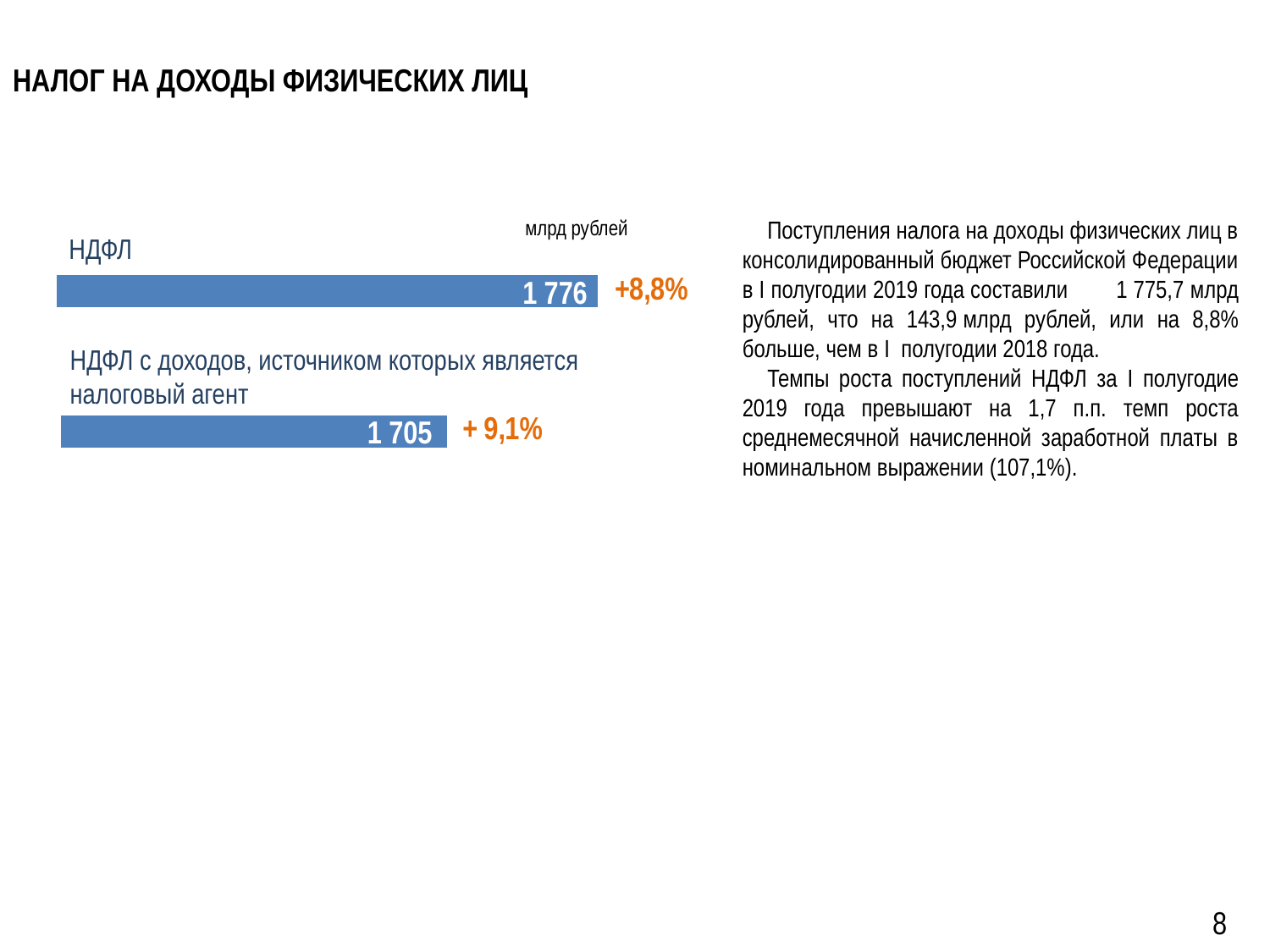
How many bars are shown in the chart? 2 What is the difference between the НДФЛ bar value and the bar for НДФЛ с доходов, источником которых является налоговый агент? 71 What growth rate is shown next to the bar for НДФЛ с доходов, источником которых является налоговый агент? + 9,1% What colour are the bars in the chart? Blue What growth rate is shown next to the НДФЛ bar? +8,8% What is the value shown on the bar for НДФЛ с доходов, источником которых является налоговый агент? 1 705 What kind of chart is shown on the slide? Bar chart What is the value shown on the bar for НДФЛ? 1 776 In what units are the bar values given? млрд рублей Which growth rate is larger: the one for НДФЛ or the one for НДФЛ с доходов, источником которых является налоговый агент? НДФЛ с доходов, источником которых является налоговый агент Which of the two bars has the lower value? НДФЛ с доходов, источником которых является налоговый агент Which of the two bars has the higher value? НДФЛ